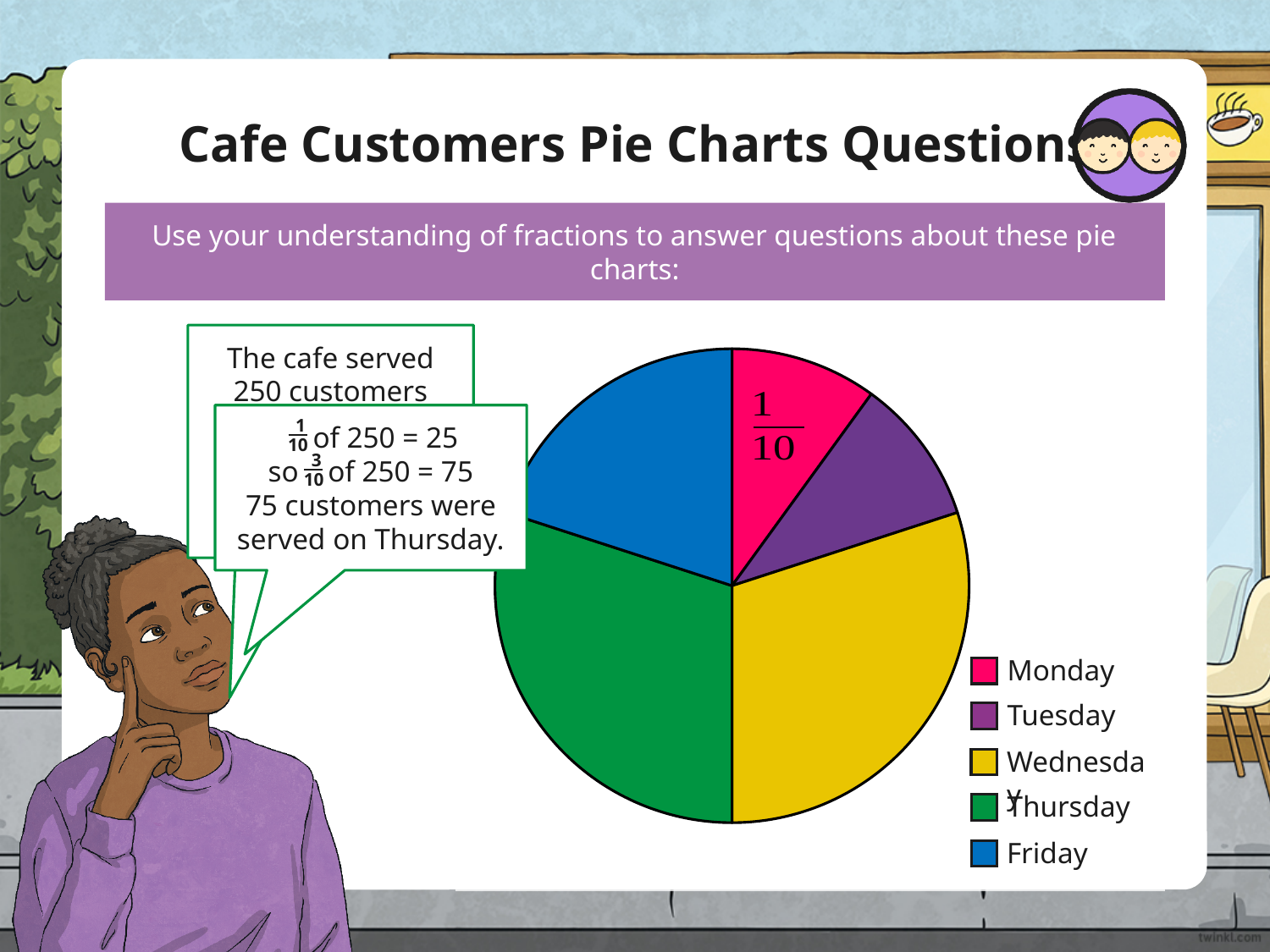
Which slice is larger, Wednesday or Monday? Wednesday How many entries does the legend list? 5 Which day is shown in green in the legend? Thursday How many slices does the pie chart have? 5 How many customers did the cafe serve in total? 250 What fraction of the pie chart is the Thursday slice? 3/10 What kind of chart is shown on the slide? pie chart Which slice is larger, Thursday or Monday? Thursday How many customers were served on Thursday? 75 What colour is the Friday slice in the pie chart? blue What fraction of the pie chart is the Monday slice? 1/10